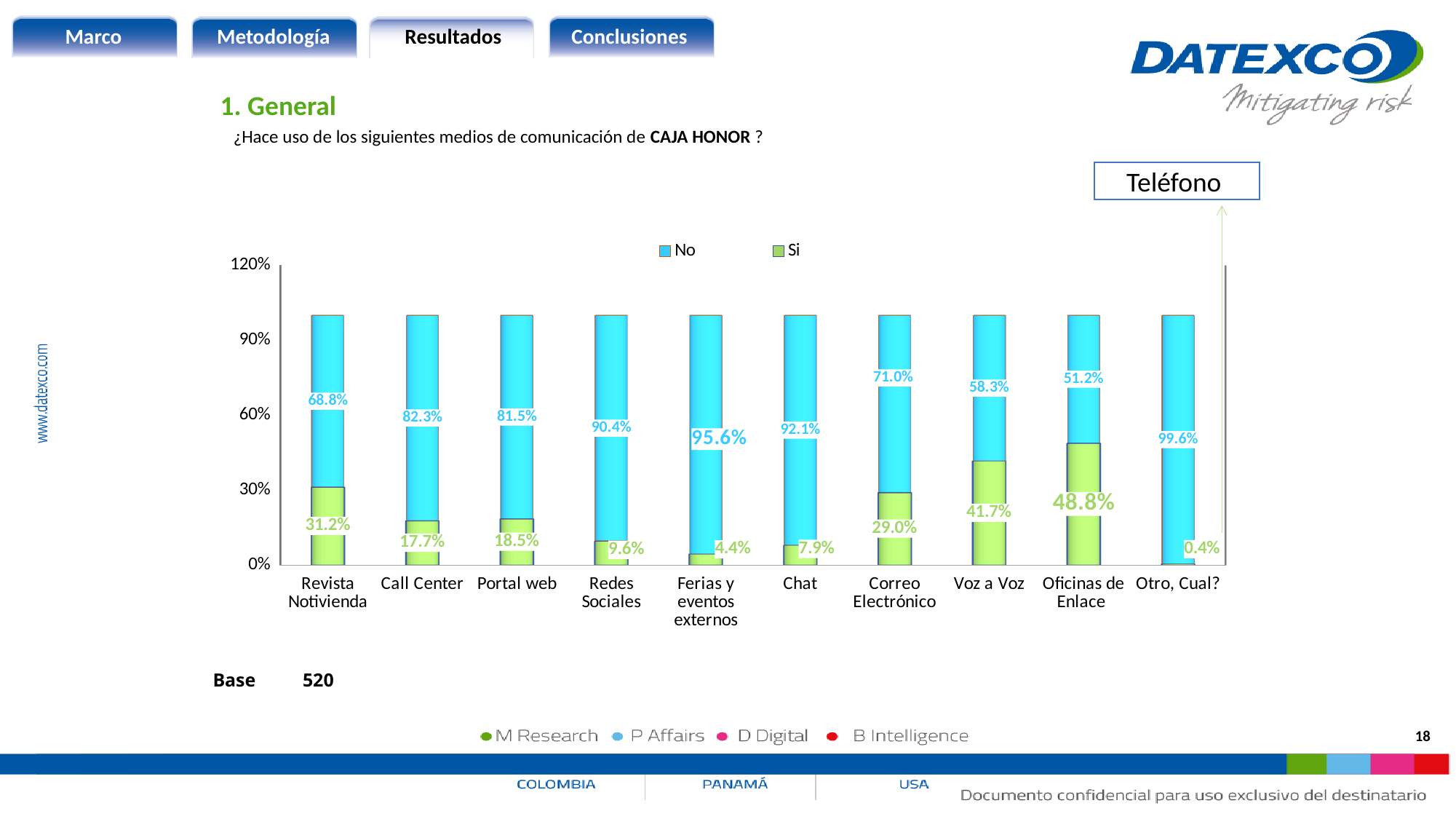
Which category has the lowest 'Si' value? Otro, Cual? What are the two legend entries of the chart? No and Si What kind of chart is shown on the slide? Stacked bar chart Which category has the highest 'Si' value? Oficinas de Enlace How many categories are shown on the x axis? 10 How many series does the legend list? 2 What is the 'Si' value for Revista Notivienda? 31.2% What is the difference between the 'Si' values for Voz a Voz and Correo Electrónico? 12.7 percentage points What is the total of the stacked bar for Revista Notivienda? 100% What is the 'No' value for Ferias y eventos externos? 95.6% Which has a larger 'No' value, Call Center or Chat? Chat What is the 'Si' value for Voz a Voz? 41.7%